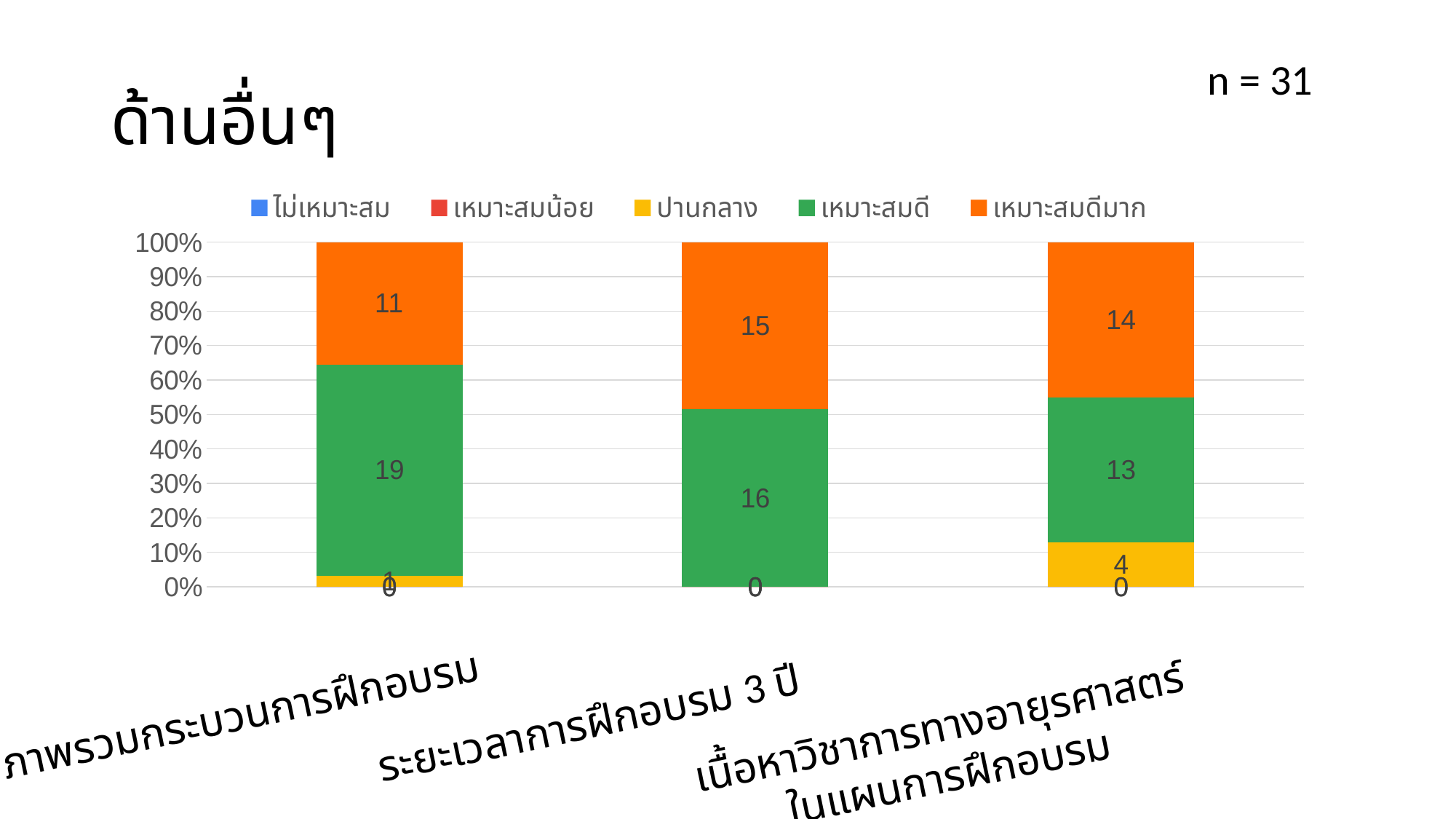
What is the value of เหมาะสมดี for ระยะเวลาการฝึกอบรม 3 ปี? 16 Which category has the lowest value for เหมาะสมดี? เนื้อหาวิชาการทางอายุรศาสตร์ในแผนการฝึกอบรม What is the difference between the เหมาะสมดี and เหมาะสมดีมาก values for ภาพรวมกระบวนการฝึกอบรม? 8 What is the title of the slide? ด้านอื่นๆ For เนื้อหาวิชาการทางอายุรศาสตร์ในแผนการฝึกอบรม, which is larger: เหมาะสมดีมาก or เหมาะสมดี? เหมาะสมดีมาก What is the value of ปานกลาง for เนื้อหาวิชาการทางอายุรศาสตร์ในแผนการฝึกอบรม? 4 How many series does the legend list? 5 How many categories are shown on the x axis? 3 What kind of chart is shown on the slide? Stacked bar chart What is the value of เหมาะสมดีมาก for ภาพรวมกระบวนการฝึกอบรม? 11 What is the total of the stacked bar for ระยะเวลาการฝึกอบรม 3 ปี? 31 Which category has the highest value for เหมาะสมดีมาก? ระยะเวลาการฝึกอบรม 3 ปี